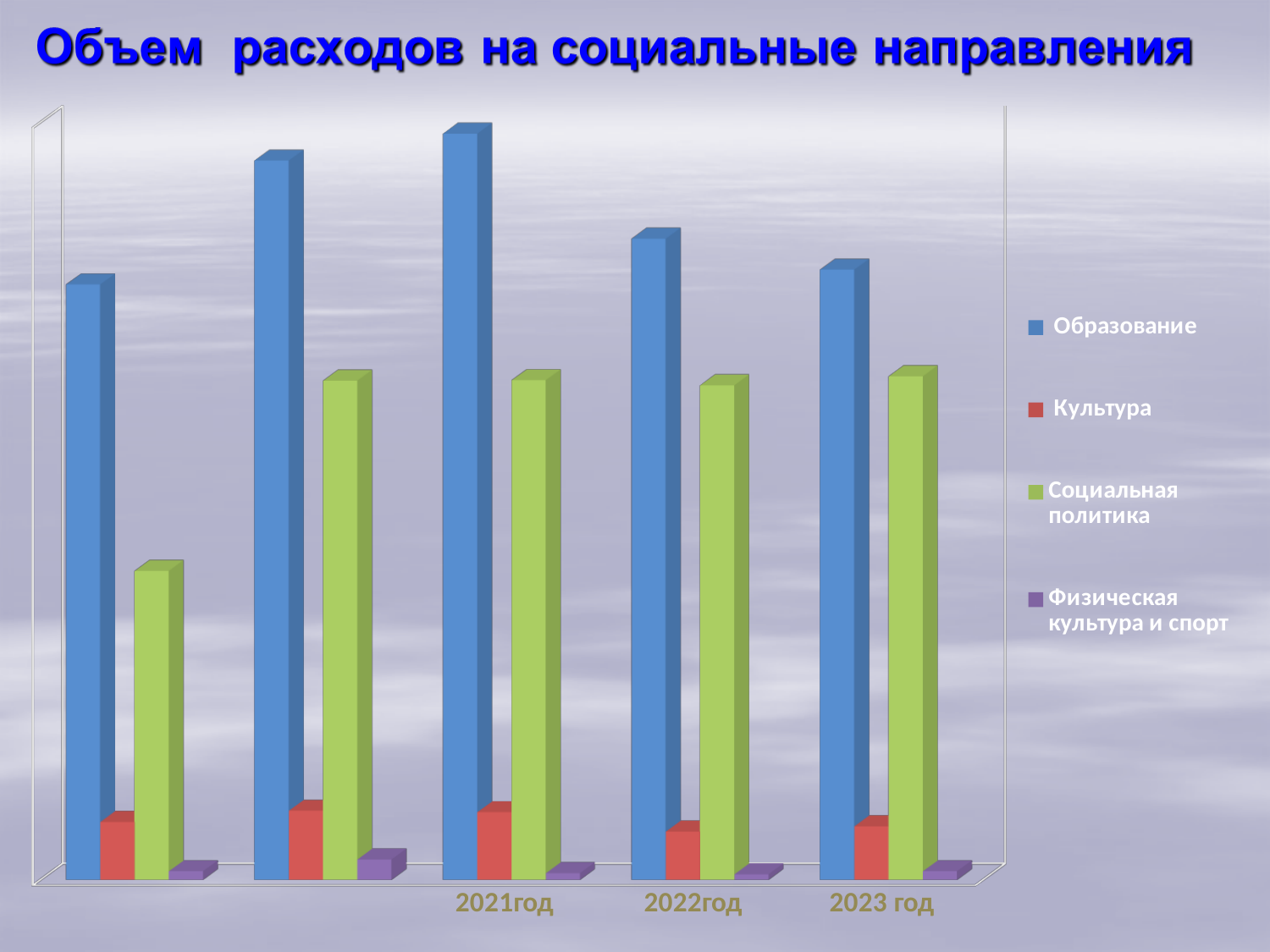
Does the Образование value rise or fall from 2021год to 2023 год? fall In 2021год, which series has the highest value? Образование Which series is shown in green in the legend? Социальная политика What type of chart is shown on the slide? bar chart In 2022год, which is larger: Культура or Социальная политика? Социальная политика Which labelled year has the highest Образование value? 2021год Of 2022год and 2023 год, which has the larger Образование value? 2022год In 2023 год, which series has the lowest value? Физическая культура и спорт What is the title of the chart? Объем расходов на социальные направления Of 2021год and 2022год, which has the larger Культура value? 2021год How many series does the legend list? 4